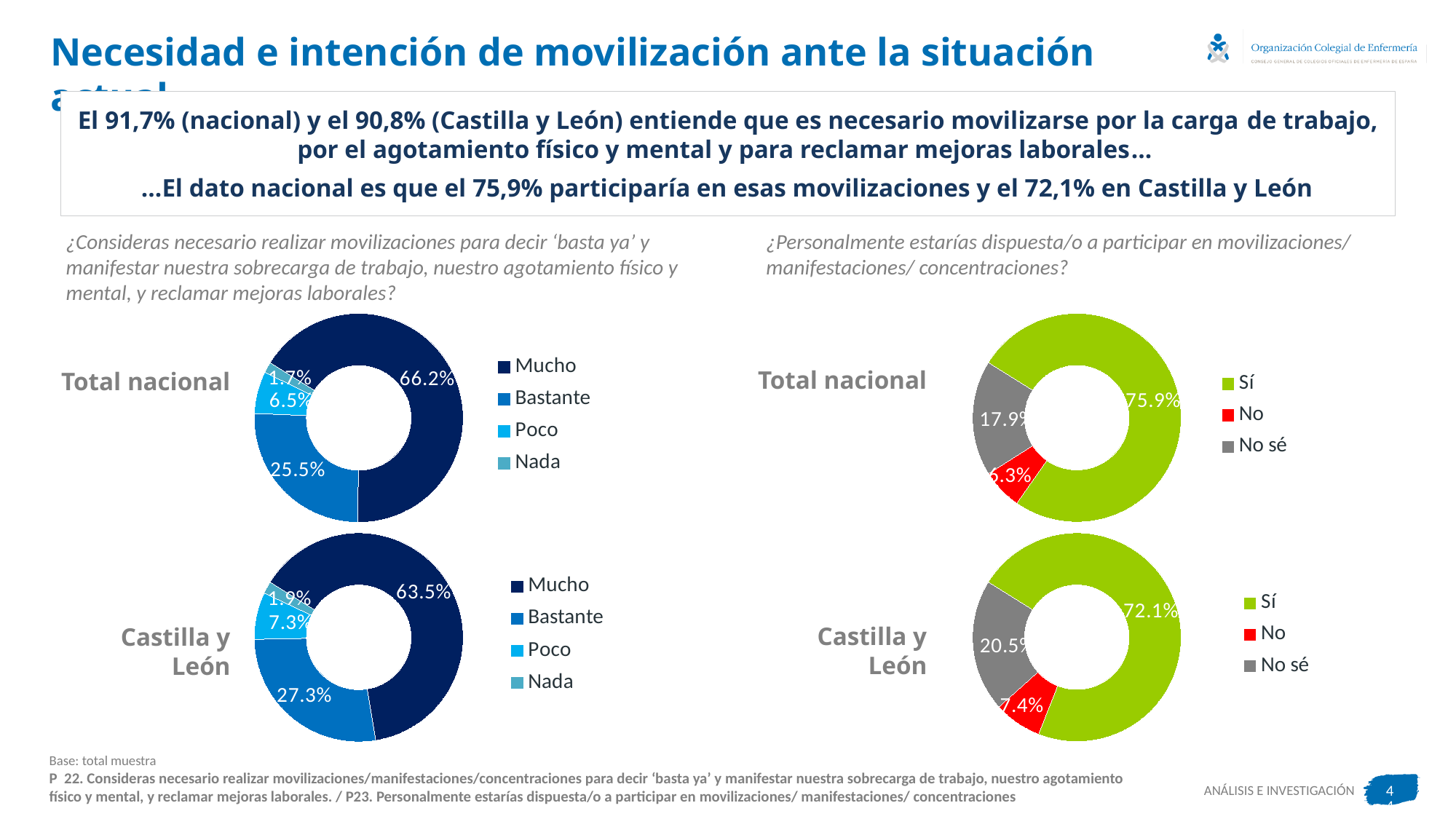
In the top-left donut chart (Total nacional, necessity of mobilizations), which category has the smallest share? Nada In the bottom-left donut chart (Castilla y León, necessity of mobilizations), what percentage is shown for Bastante? 27.3% Which is larger: the Poco share in the top-left chart (Total nacional) or the Poco share in the bottom-left chart (Castilla y León)? Castilla y León (7.3%) What is the difference between the Sí share in the top-right chart (Total nacional) and the Sí share in the bottom-right chart (Castilla y León)? 3.8% In the top-left donut chart (Total nacional, necessity of mobilizations), what percentage is shown for Mucho? 66.2% How many categories does the legend of the top-left donut chart (Total nacional, necessity of mobilizations) list? 4 How many categories does the legend of the bottom-right donut chart (Castilla y León, willingness to participate) list? 3 In the top-right donut chart (Total nacional, willingness to participate), what percentage is shown for No sé? 17.9% In the bottom-right donut chart (Castilla y León, willingness to participate), what percentage is shown for No? 7.4% In the top-right donut chart (Total nacional, willingness to participate), what colour represents No? Red In the bottom-right donut chart (Castilla y León, willingness to participate), which category has the largest share? Sí What type of chart is used for the Total nacional chart on the right side of the slide? Donut (pie) chart